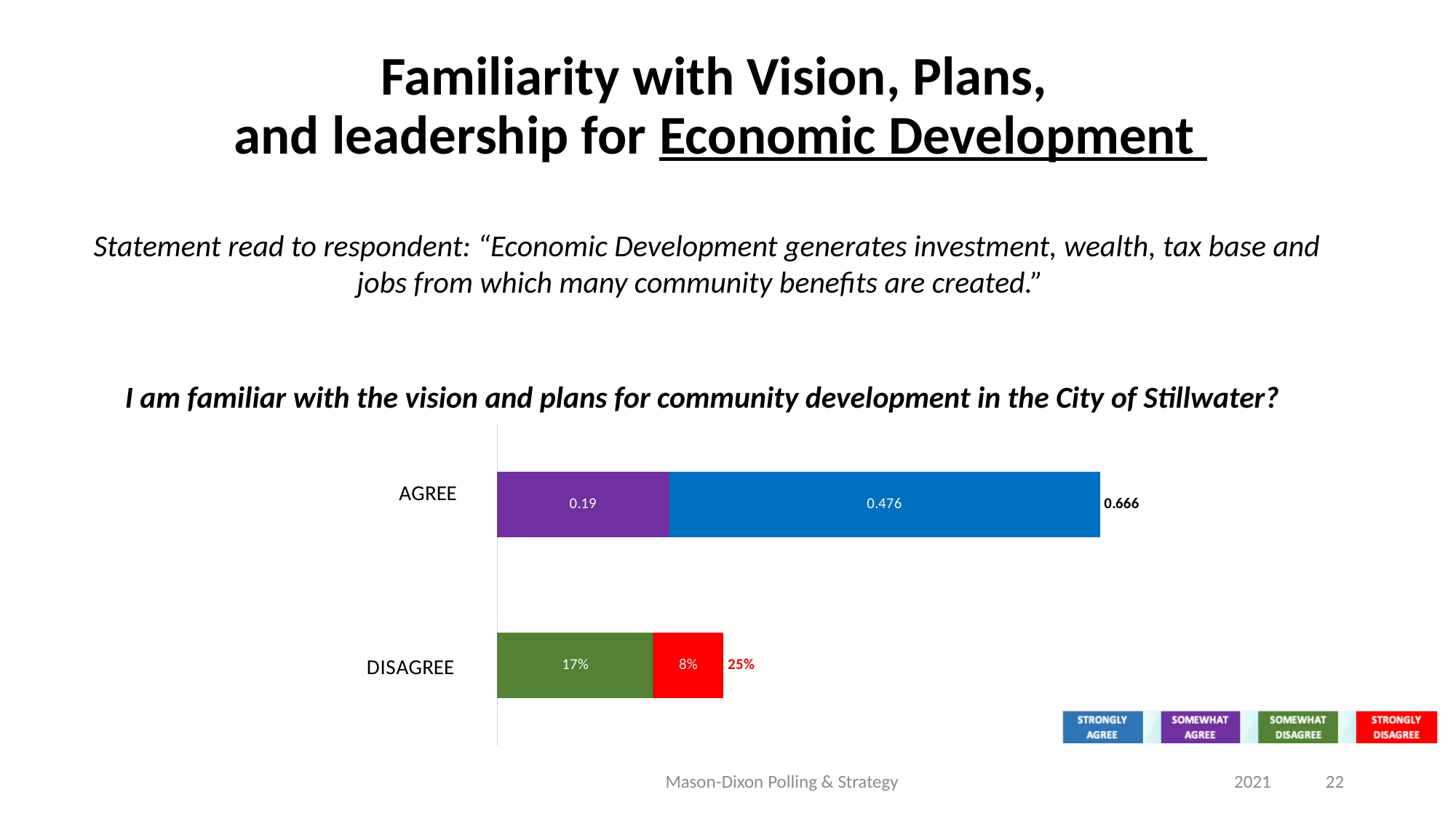
Within the DISAGREE bar, which segment is larger, Somewhat Disagree or Strongly Disagree? Somewhat Disagree What is the value of the purple (Somewhat Agree) segment of the AGREE bar? 0.19 What is the difference between the Somewhat Disagree and Strongly Disagree values in the DISAGREE bar? 9% How many entries does the legend list? 4 Which category has the longer bar, AGREE or DISAGREE? AGREE What is the value of the green (Somewhat Disagree) segment of the DISAGREE bar? 17% What is the total value labelled at the end of the AGREE bar? 0.666 What is the value of the red (Strongly Disagree) segment of the DISAGREE bar? 8% How many categories (bars) are shown in the chart? 2 What is the value of the blue (Strongly Agree) segment of the AGREE bar? 0.476 What type of chart is shown on the slide? Stacked bar chart What is the total value labelled at the end of the DISAGREE bar? 25%